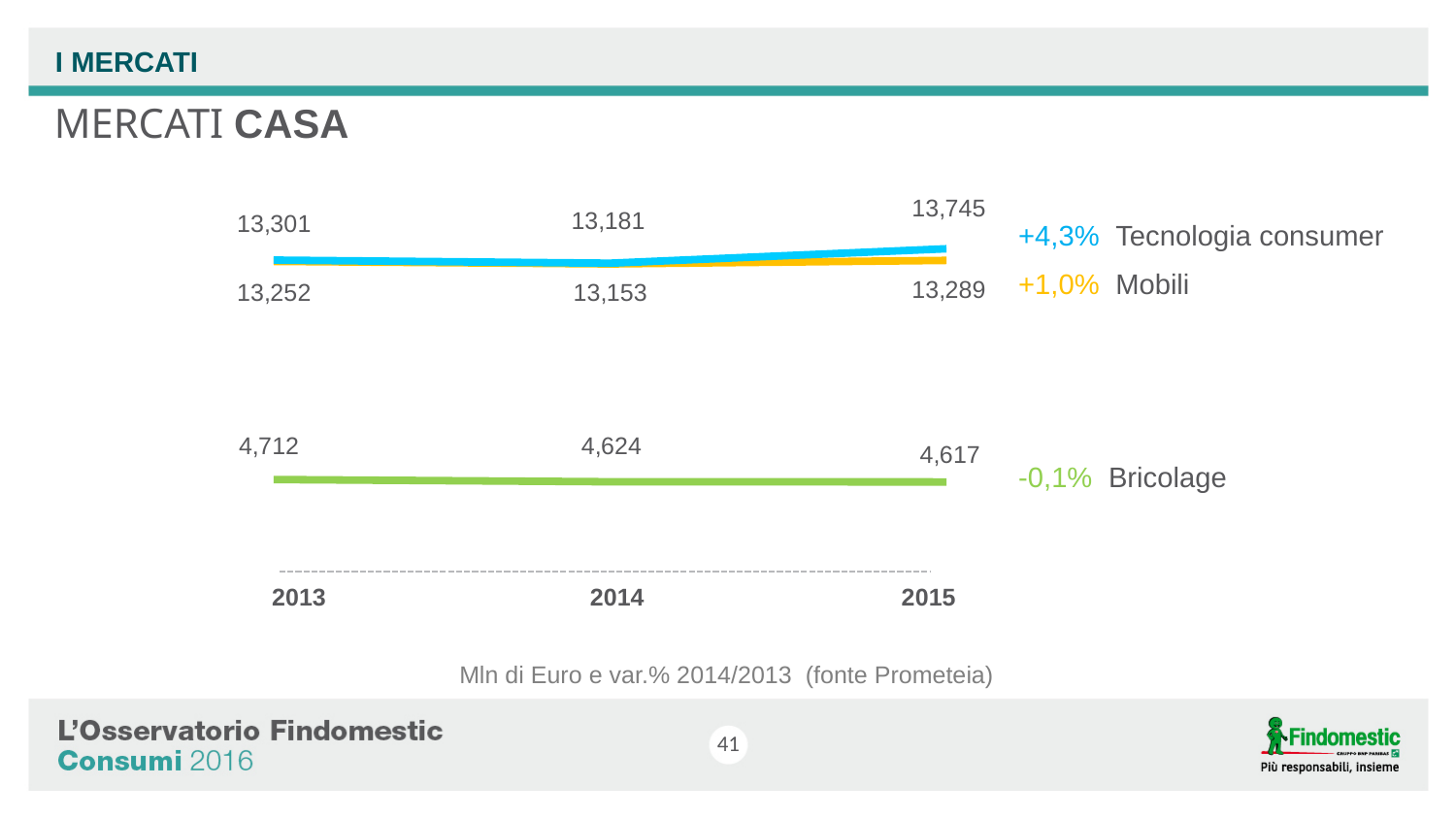
Which is larger in 2013: the Tecnologia consumer value or the Mobili value? Tecnologia consumer What is the value for Tecnologia consumer in 2015? 13,745 What is the value for Mobili in 2013? 13,252 What is the difference between the Tecnologia consumer and Mobili values in 2015? 456 How many years are shown on the x axis? 3 What kind of chart is shown on the slide? Line chart What is the value for Tecnologia consumer in 2014? 13,181 In which year is the Tecnologia consumer value highest? 2015 How many series does the chart show? 3 In which year is the Bricolage value lowest? 2015 What percentage change is shown next to Bricolage? -0,1% What is the value for Bricolage in 2014? 4,624